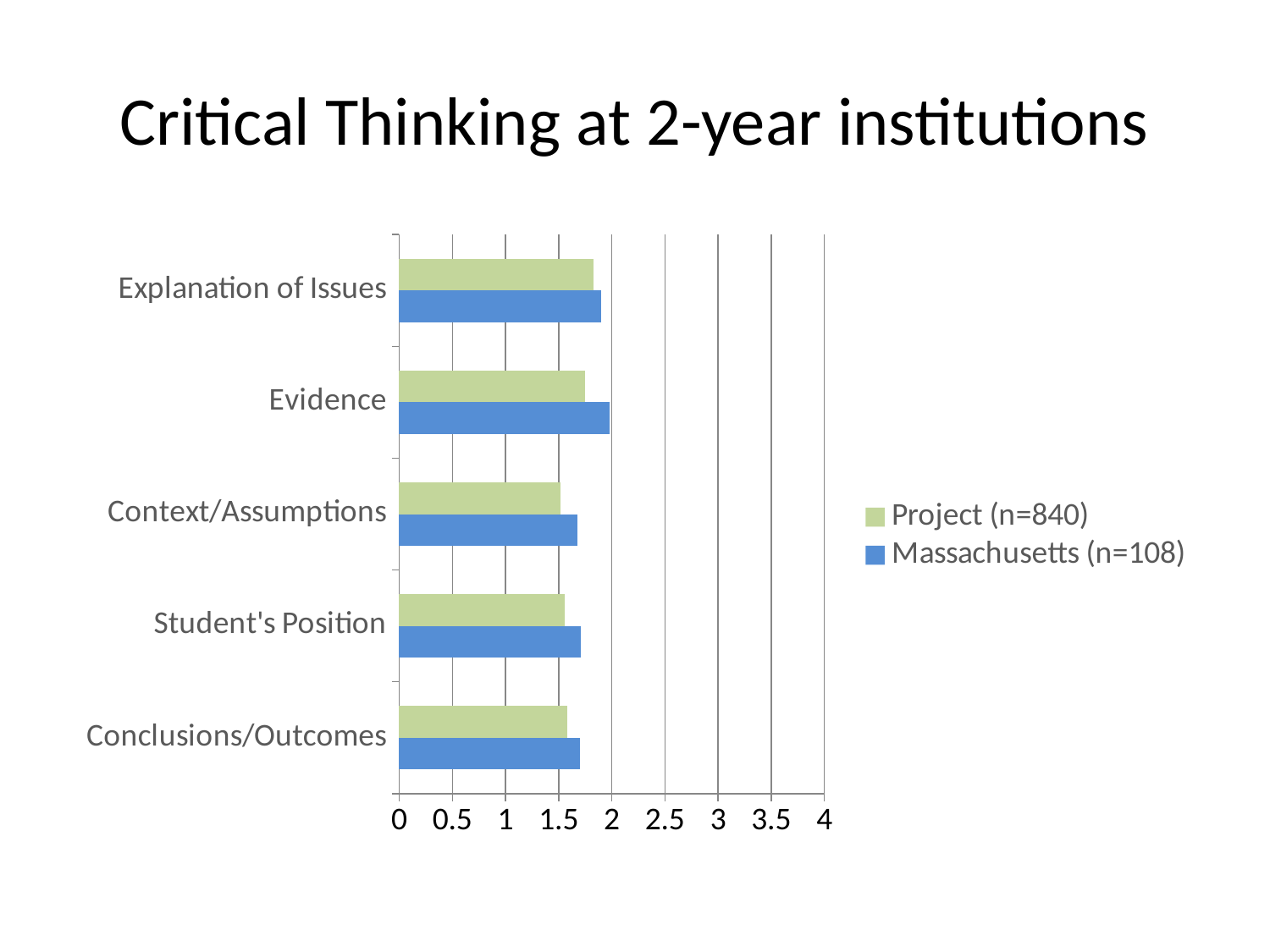
For Evidence, which series has the larger value, Project (n=840) or Massachusetts (n=108)? Massachusetts (n=108) Which series is shown in blue? Massachusetts (n=108) What is the title of the chart? Critical Thinking at 2-year institutions Is the Project (n=840) value for Context/Assumptions greater or less than 2? less For Context/Assumptions, which series has the larger value, Project (n=840) or Massachusetts (n=108)? Massachusetts (n=108) Which category has the highest Massachusetts (n=108) value? Evidence How many categories are shown on the chart? 5 Is the Massachusetts (n=108) value for Conclusions/Outcomes greater or less than 1? greater Is the Project (n=840) value for Explanation of Issues greater or less than 1.5? greater What kind of chart is shown on the slide? bar chart How many series does the legend list? 2